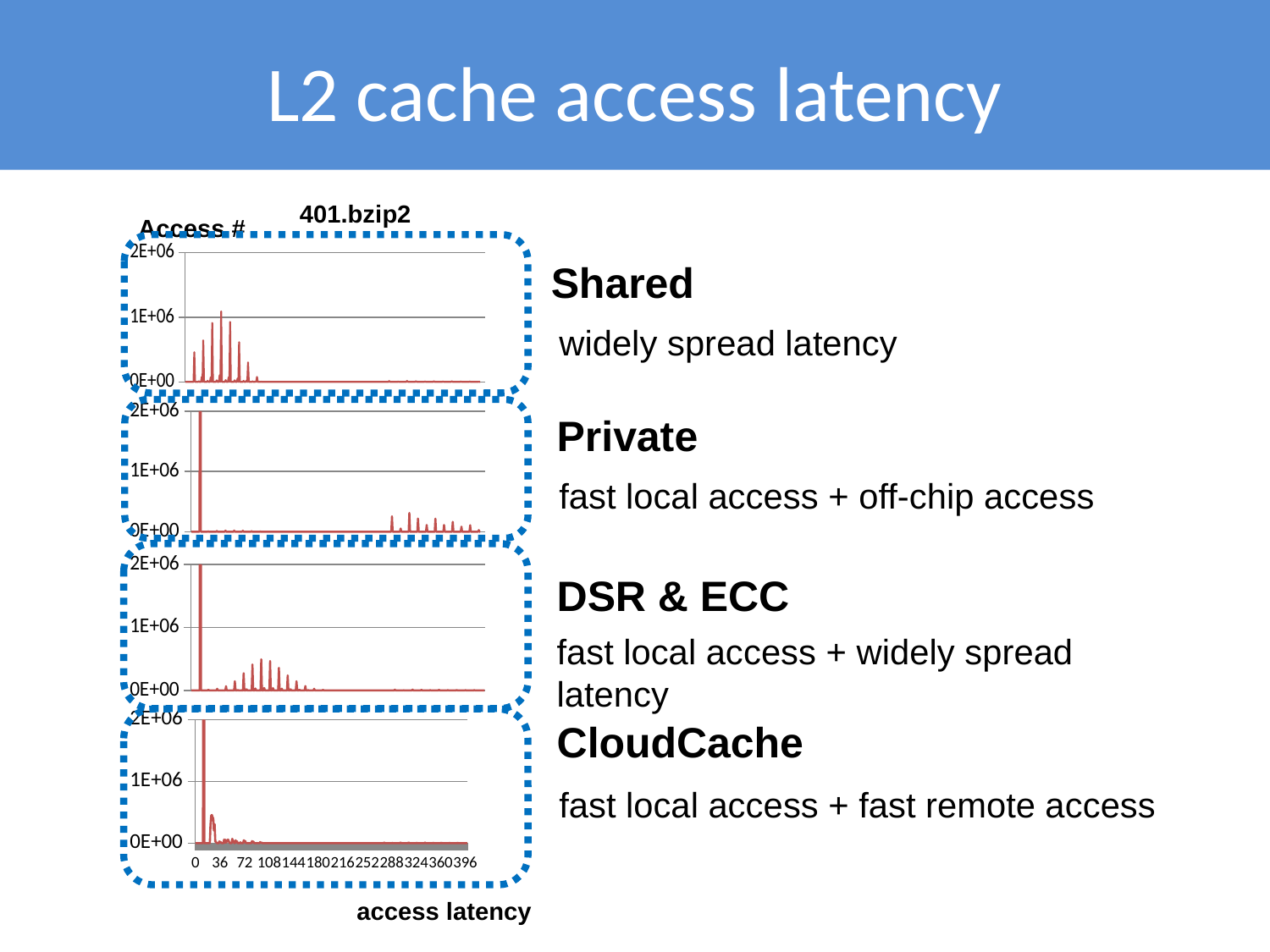
How many chart panels are stacked on the left side of the slide? 4 In the top (Shared) chart, is the value at access latency 396 greater or less than 1E+06? less What label is given to the vertical axis of the stacked charts? Access # In the bottom (CloudCache) chart, is the value at access latency 216 greater or less than 1E+06? less In the third (DSR & ECC) chart, is the tallest peak greater or less than 1E+06? greater What is the title printed above the stacked charts? 401.bzip2 Is the tallest peak in the top (Shared) chart higher or lower than the tallest peak in the second (Private) chart? lower What kind of chart is used in each of the four panels on the slide? line chart